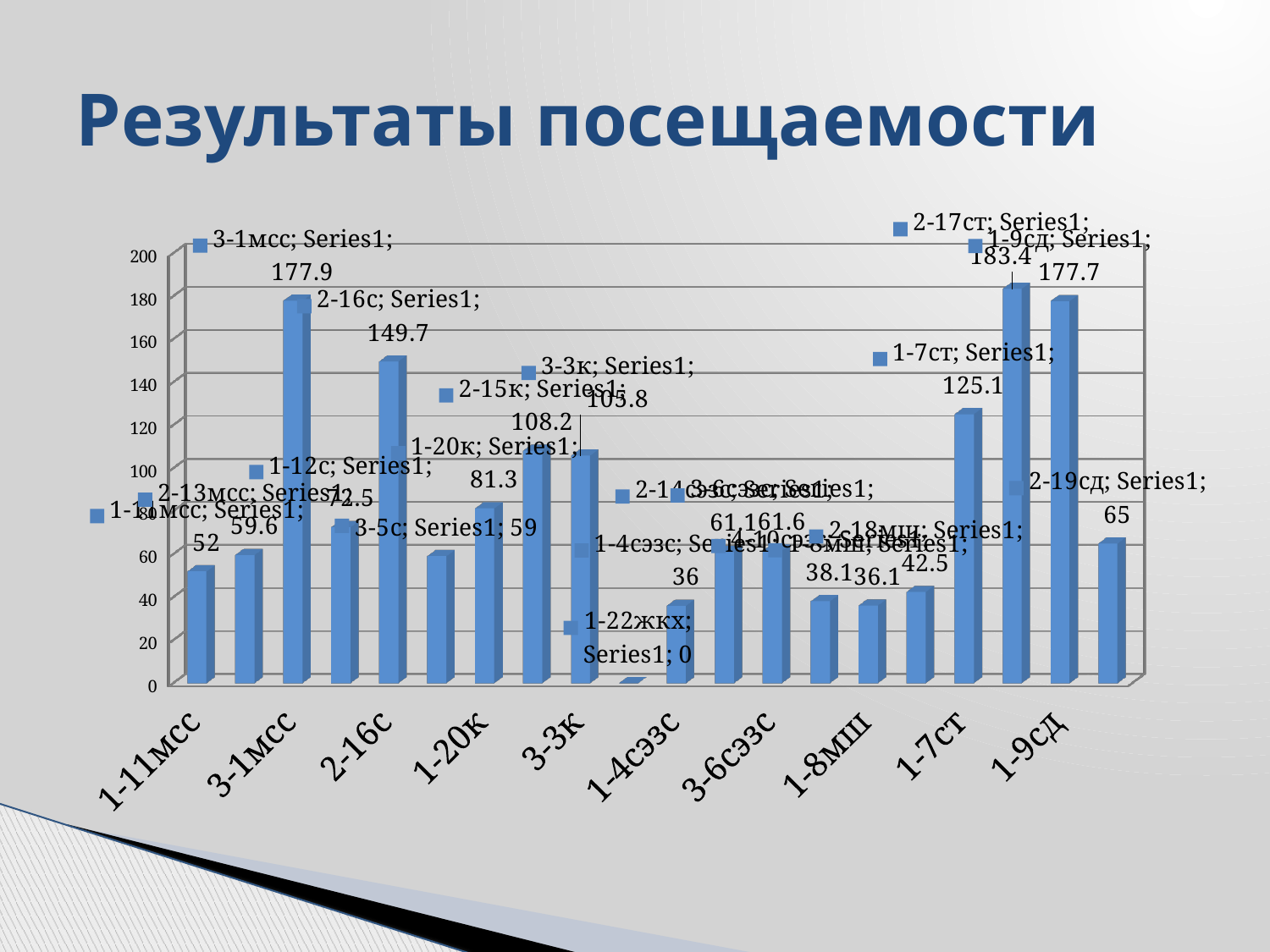
Which category has the lowest value? 1-22жкх What is the value for 2-16с? 149.7 Is the value for 1-20к greater or less than 100? less Which is larger, the value for 2-15к or the value for 3-3к? 2-15к What is the value for 1-7ст? 125.1 Which category has the highest value? 2-17ст What is the value for 3-1мсс? 177.9 What is the title of the slide? Результаты посещаемости What is the difference between the values for 2-17ст and 1-9сд? 5.7 What is the value for 1-4сэзс? 36 What is the value for 2-19сд? 65 What kind of chart is shown on the slide? bar chart